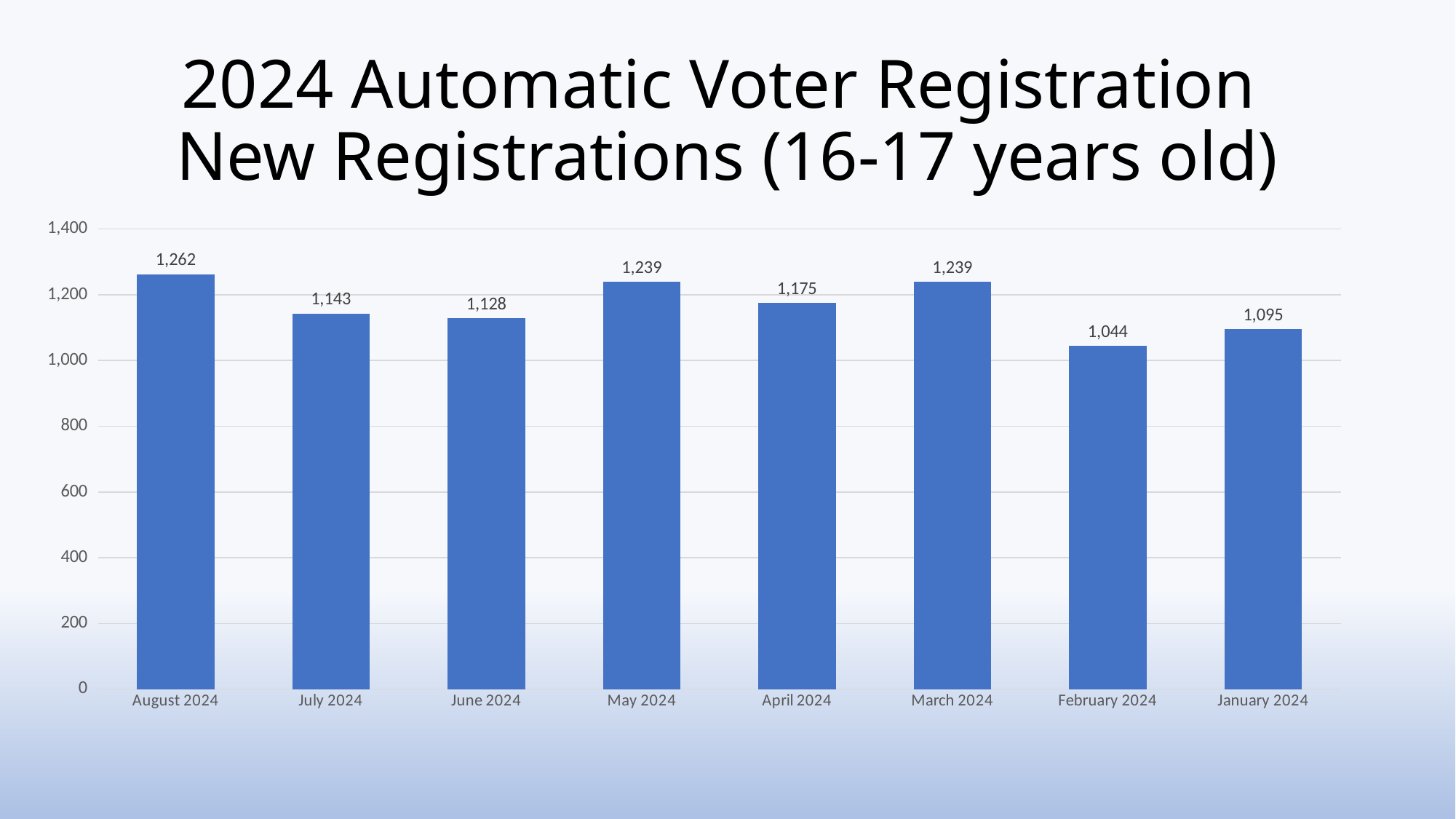
What kind of chart is shown on the slide? bar chart What is the difference between the values for August 2024 and February 2024? 218 Which month has the highest value? August 2024 Which month has the lowest value? February 2024 What is the value for February 2024? 1,044 How many months are shown on the chart? 8 What is the title of the chart? 2024 Automatic Voter Registration New Registrations (16-17 years old) What is the value for April 2024? 1,175 Which is larger, the value for January 2024 or the value for June 2024? June 2024 Is the value for March 2024 greater or less than 1,200? greater What is the value for August 2024? 1,262 What is the difference between the values for July 2024 and June 2024? 15